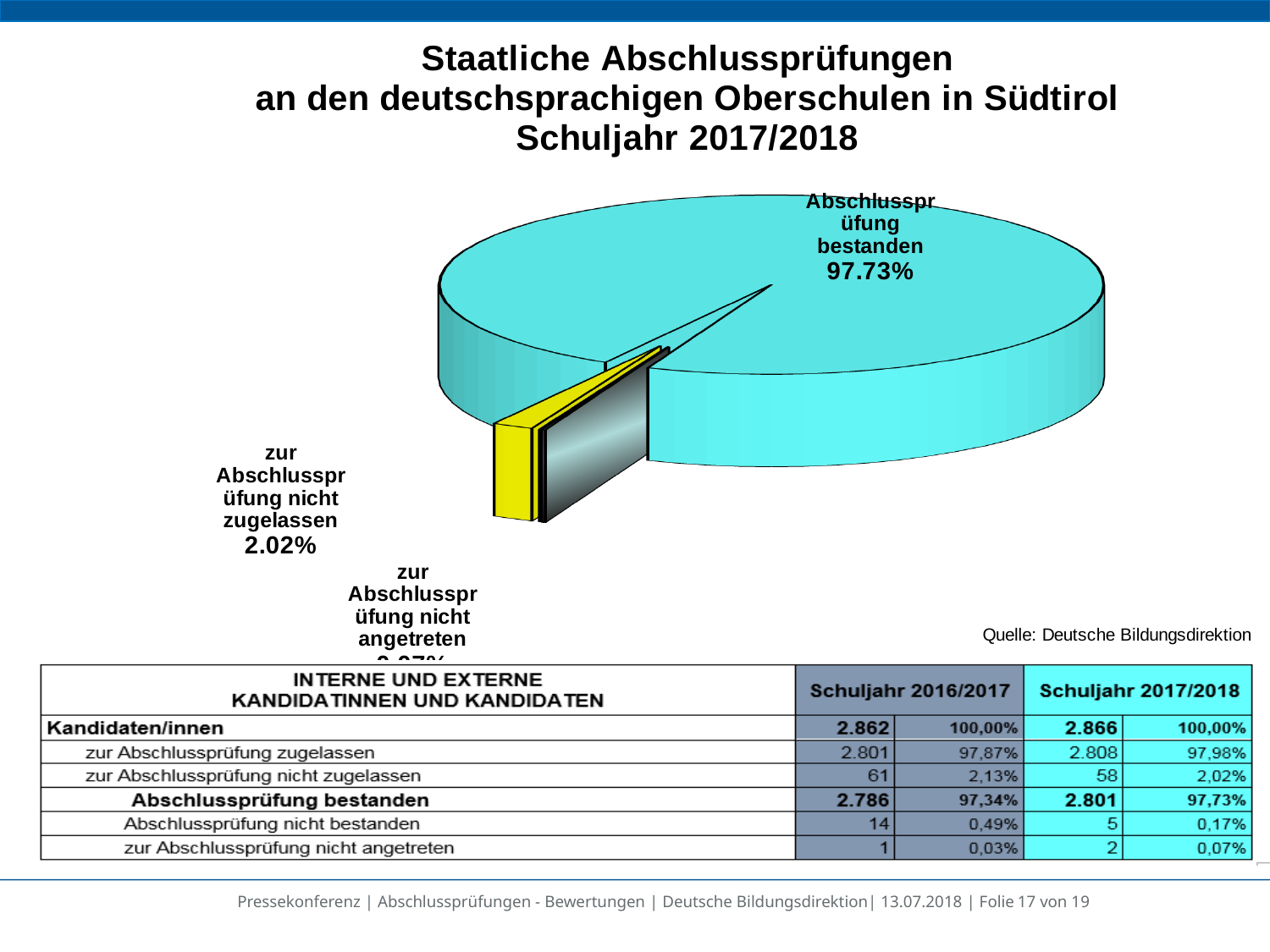
What is the difference in percentage points between "Abschlussprüfung bestanden" and "zur Abschlussprüfung nicht zugelassen" in the pie chart? 95.71% What colour is the largest slice of the pie chart? cyan (light blue) What percentage does the pie chart show for "Abschlussprüfung bestanden"? 97.73% Which category has the largest slice in the pie chart? Abschlussprüfung bestanden What percentage does the pie chart show for "zur Abschlussprüfung nicht zugelassen"? 2.02% What share of the pie does the "Abschlussprüfung bestanden" slice represent? 97.73% What kind of chart is shown on the slide? pie chart What school year does the chart title refer to? Schuljahr 2017/2018 Which is larger in the pie chart: "Abschlussprüfung bestanden" or "zur Abschlussprüfung nicht zugelassen"? Abschlussprüfung bestanden